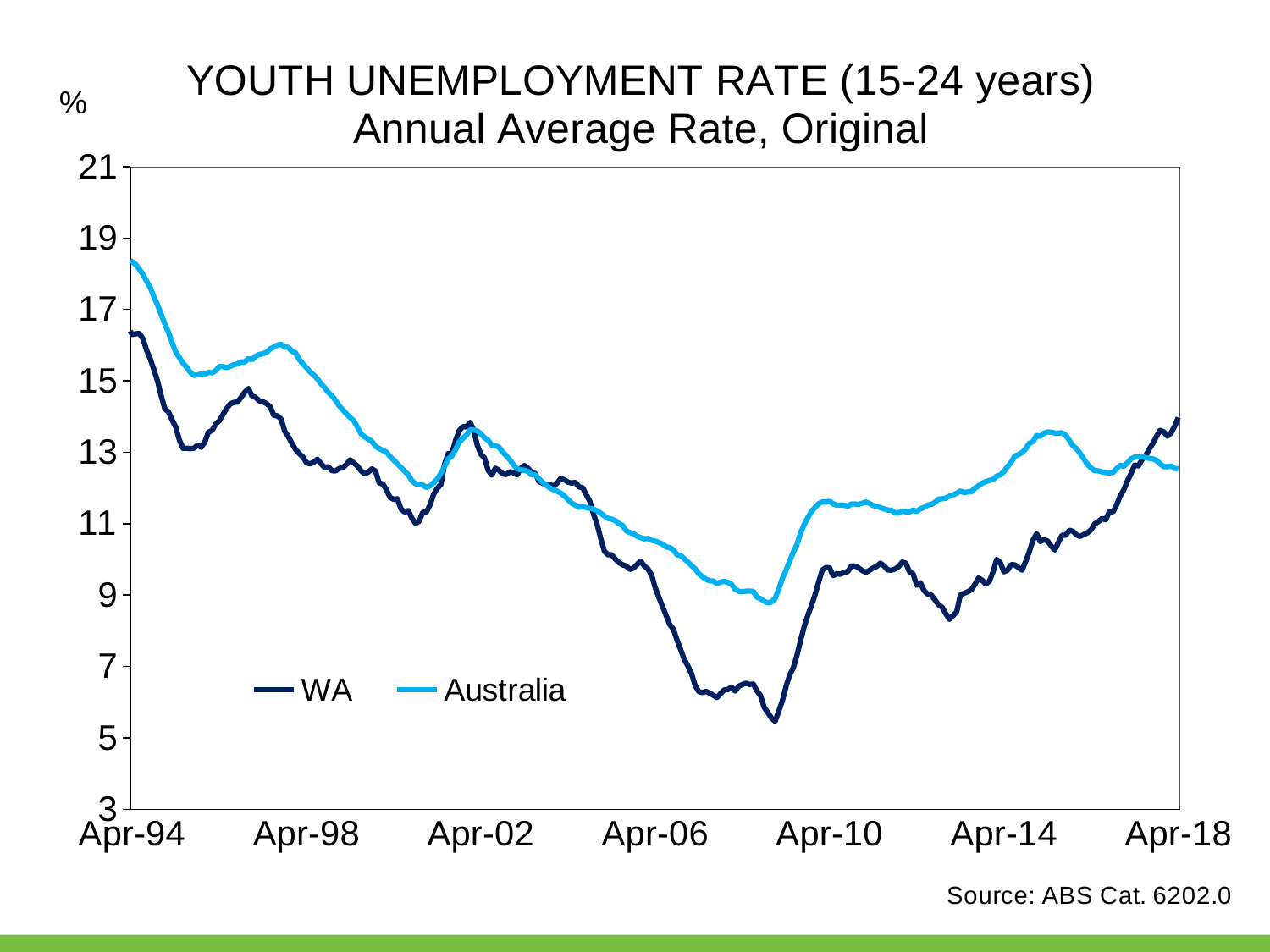
At Apr-18, which series has the higher youth unemployment rate, WA or Australia? WA How many series does the legend list? 2 Does the WA line generally rise or fall between Apr-10 and Apr-18? rise Is the WA youth unemployment rate at Apr-94 greater or less than 15? greater What kind of chart is shown on the slide? line chart Is the Australia youth unemployment rate at Apr-94 greater or less than 17? greater What is the source cited below the chart? ABS Cat. 6202.0 At Apr-94, which series has the higher youth unemployment rate, WA or Australia? Australia Is the lowest point of the WA line greater or less than 7? less What are the two series named in the legend? WA and Australia